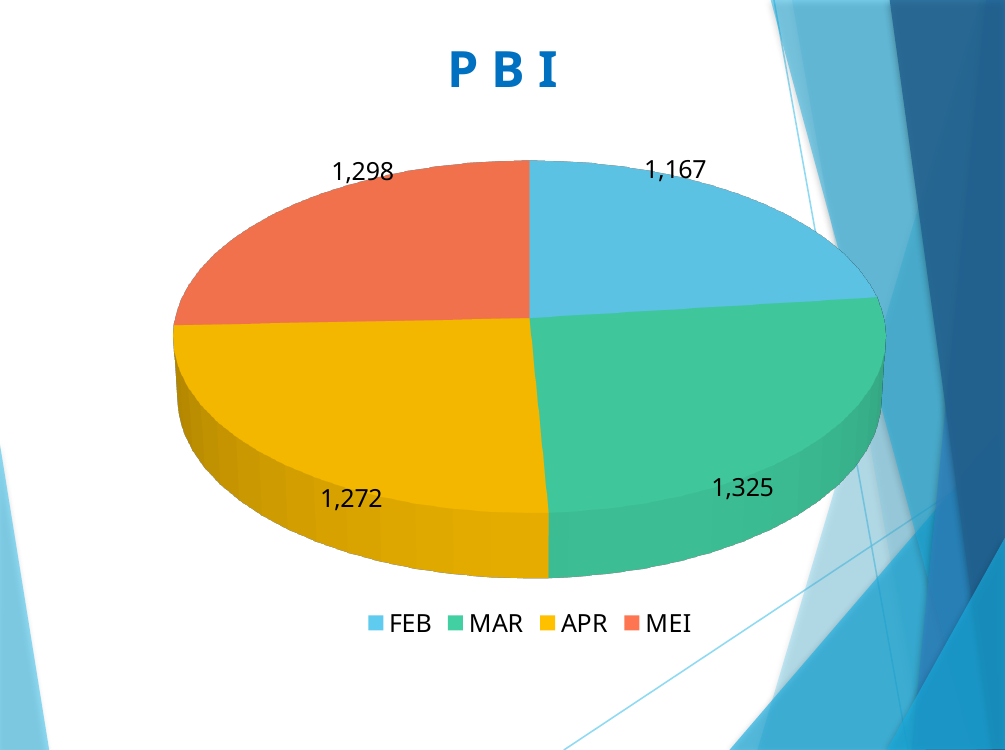
What is the difference between the values for MAR and FEB? 158 What is the difference between the values for MEI and APR? 26 What is the value for MAR in the pie chart? 1,325 What is the value for APR in the pie chart? 1,272 Which is larger, the value for MAR or the value for APR? MAR Which category has the largest slice in the pie chart? MAR How many slices does the pie chart have? 4 What is the title of the chart? P B I What is the value for MEI in the pie chart? 1,298 What kind of chart is shown on the slide? Pie chart What is the value for FEB in the pie chart? 1,167 Which category has the smallest slice in the pie chart? FEB